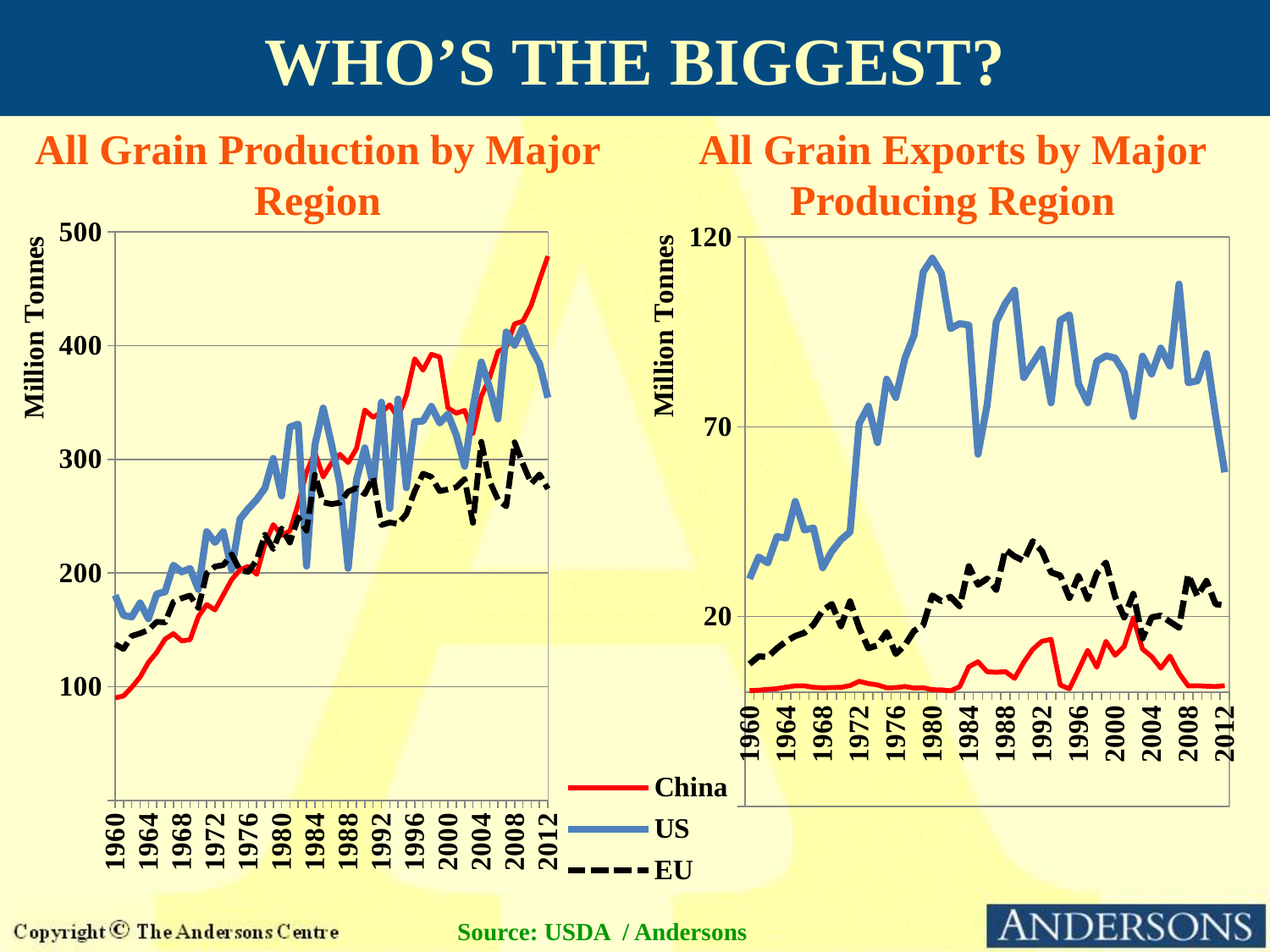
What kind of chart is the 'All Grain Production by Major Region' chart? line chart In the 'All Grain Exports by Major Producing Region' chart, which region has the highest exports in 1980? US In the 'All Grain Exports by Major Producing Region' chart, is the value for the US in 1980 greater or less than 70? greater In the 'All Grain Production by Major Region' chart, is the value for the US in 1960 greater or less than 200? less How many series does the legend list for the charts on the slide? 3 In the 'All Grain Production by Major Region' chart, which region has the higher production in 2012, China or the US? China What unit is shown on the y-axis of the 'All Grain Exports by Major Producing Region' chart? Million Tonnes In the 'All Grain Exports by Major Producing Region' chart, which region has the lowest exports in 1976? China In the 'All Grain Production by Major Region' chart, does China's production generally rise or fall from 1960 to 2012? rise In the 'All Grain Production by Major Region' chart, is the value for China in 2012 greater or less than 400? greater